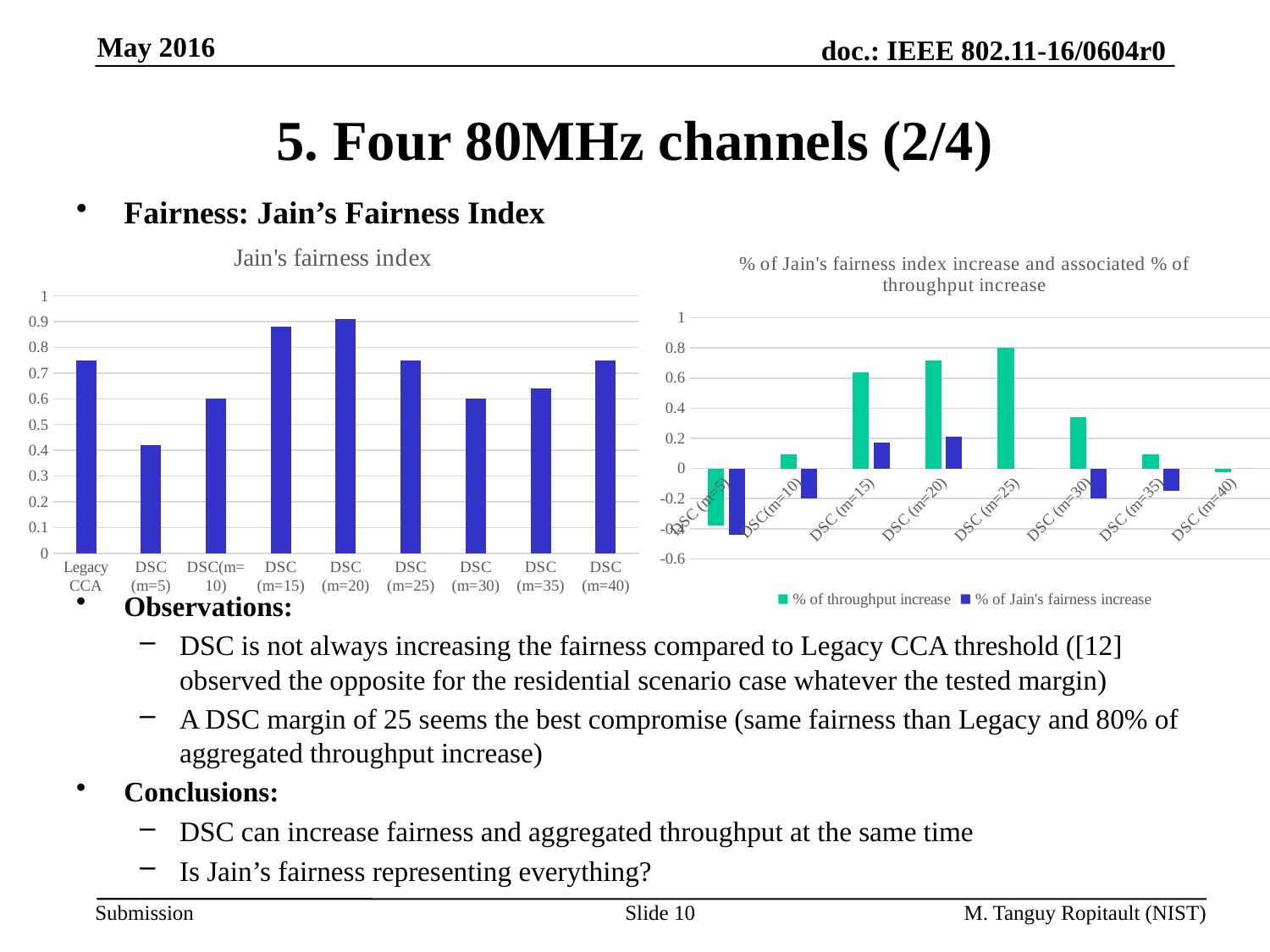
In the "Jain's fairness index" chart, which category has the lowest value? DSC (m=5) In the right-hand chart, is the % of throughput increase for DSC (m=25) greater or less than 0.6? greater In the right-hand chart, which category has the highest % of throughput increase? DSC (m=25) How many series does the legend of the right-hand chart ("% of Jain's fairness index increase and associated % of throughput increase") list? 2 What kind of chart is the "Jain's fairness index" chart on the left? bar chart In the right-hand chart, what colour represents the "% of throughput increase" series? green In the "Jain's fairness index" chart, which is larger: the value for DSC (m=15) or the value for DSC (m=30)? DSC (m=15) How many categories are shown on the x axis of the right-hand chart? 8 In the right-hand chart, is the % of Jain's fairness increase for DSC (m=5) greater or less than -0.2? less How many categories are shown on the x axis of the "Jain's fairness index" chart? 9 In the "Jain's fairness index" chart, is the value for Legacy CCA greater or less than 0.7? greater